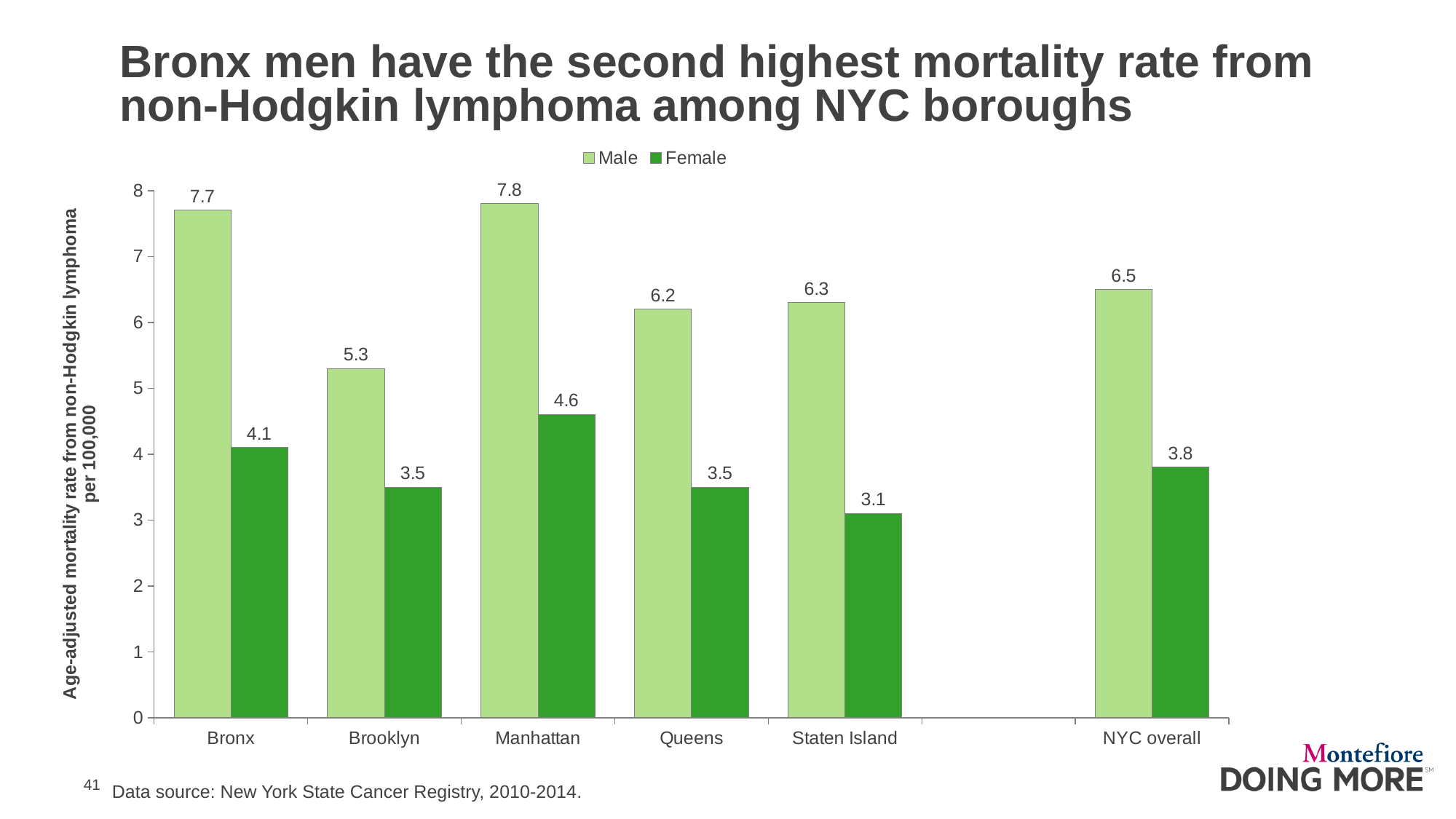
Which borough has the highest male mortality rate? Manhattan What is the difference between the male and female mortality rates in Brooklyn? 1.8 Is the female mortality rate for the Bronx greater or less than 4? greater What is the male mortality rate for the Bronx? 7.7 Which borough has the lowest female mortality rate? Staten Island What kind of chart is shown on the slide? Bar chart Which is larger, the male mortality rate for Queens or for Staten Island? Staten Island How many categories are shown on the x axis? 6 What is the male mortality rate for NYC overall? 6.5 How many series does the legend list? 2 What is the female mortality rate for Manhattan? 4.6 Which series is shown in dark green? Female